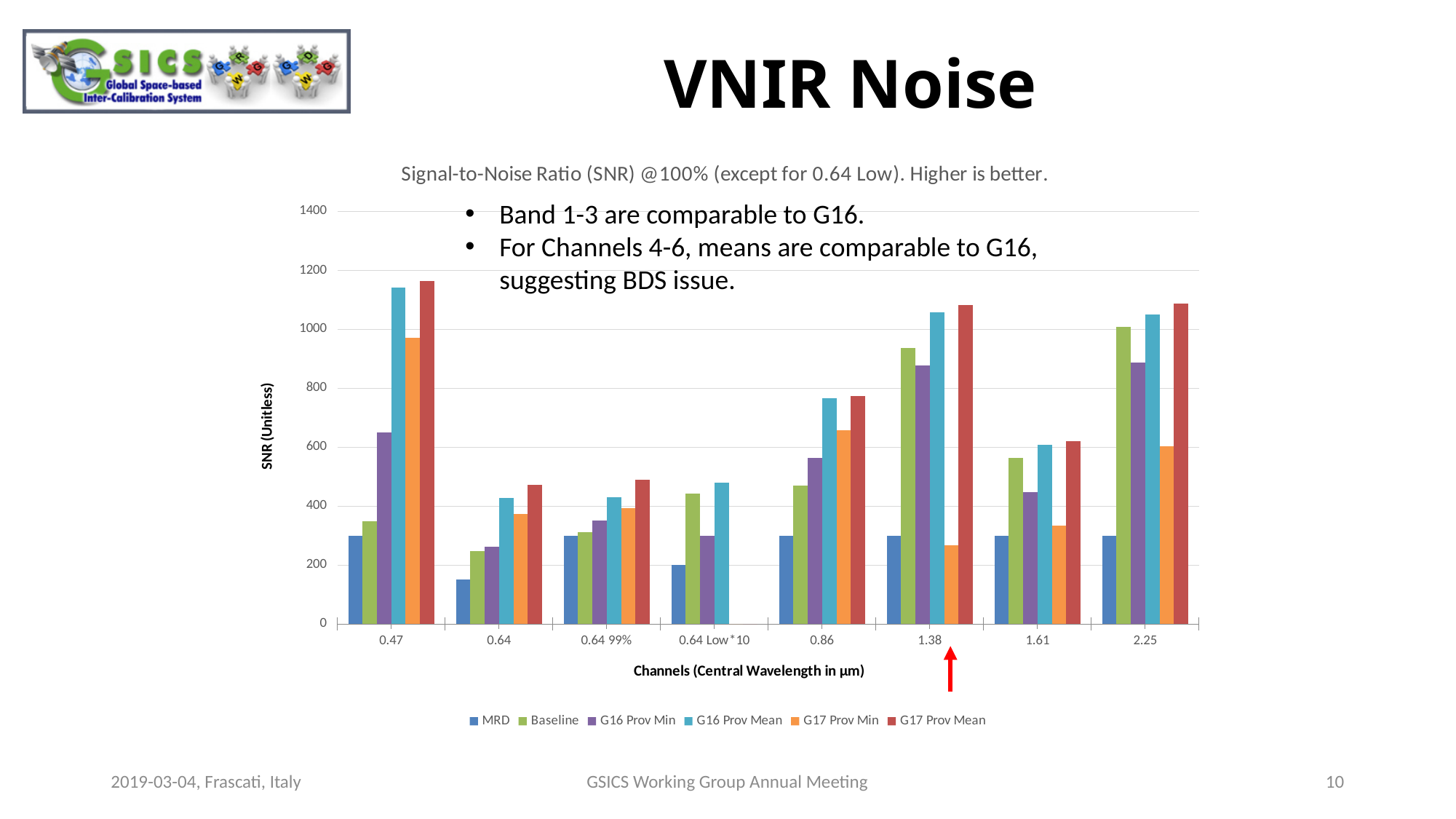
What is the label of the x axis? Channels (Central Wavelength in μm) How many series does the legend list? 6 Which channel has the lowest MRD value? 0.64 What is the label of the y axis? SNR (Unitless) Which channel has the highest G17 Prov Mean value? 0.47 Is the G17 Prov Mean value for the 0.47 channel greater or less than 1000? greater How many channel categories are shown on the x axis? 8 For the 1.38 channel, which is larger: G16 Prov Min or G17 Prov Min? G16 Prov Min Is the G16 Prov Min value for the 1.61 channel greater or less than 400? greater Is the MRD value for the 0.64 channel greater or less than 200? less What kind of chart is shown on the slide? bar chart